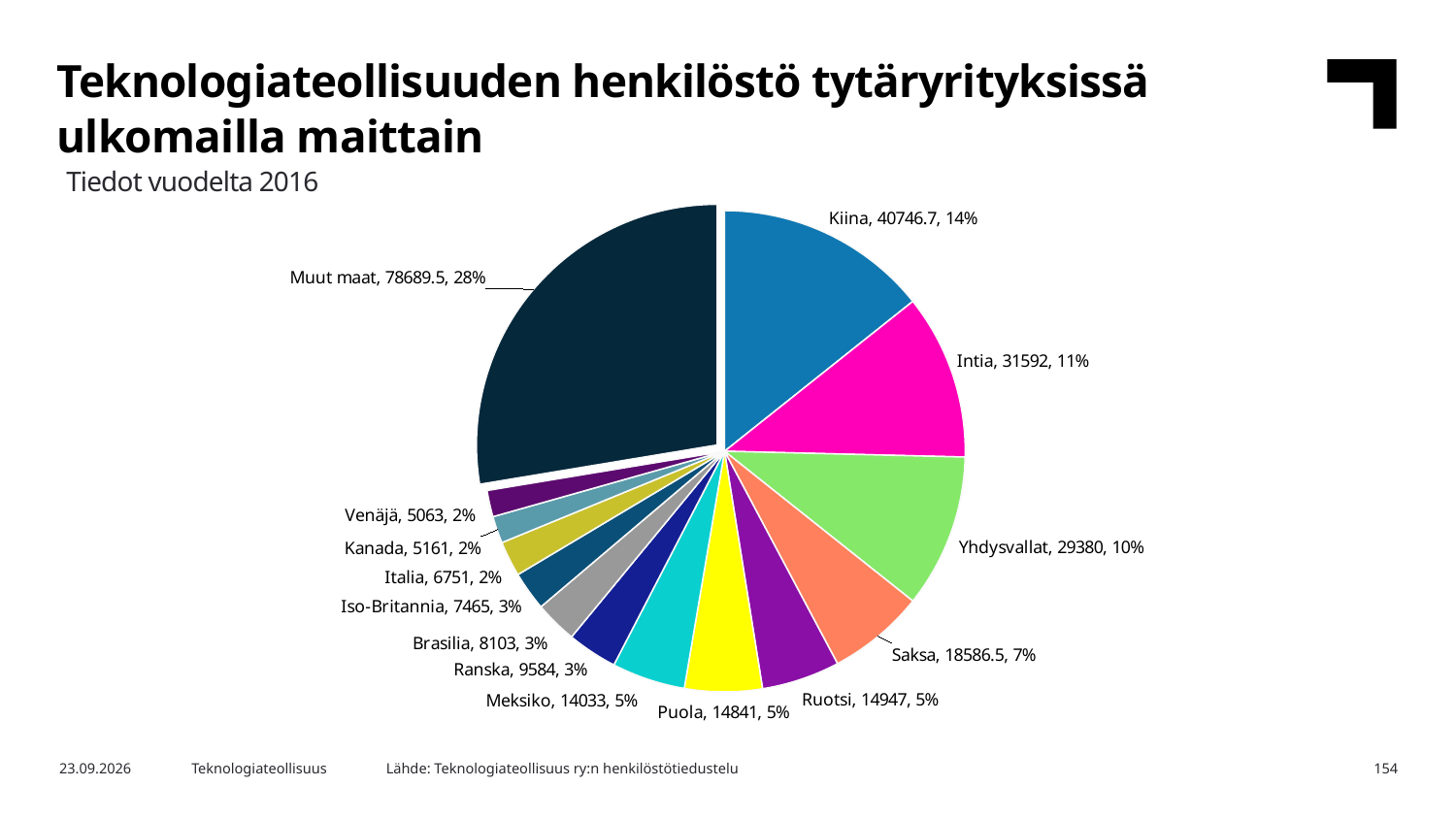
Which country slice has the smallest value? Venäjä Which slice has the largest value? Muut maat What is the difference between the values for Intia and Yhdysvallat? 2212 Which year does the data on the slide come from? 2016 What share of the pie does Muut maat represent? 28% What type of chart is shown on the slide? pie chart Which is larger, the value for Ruotsi or the value for Puola? Ruotsi What is the value for Kiina? 40746.7 What is the value for Meksiko? 14033 What is the value for Saksa? 18586.5 What share of the pie does Intia represent? 11% How many slices does the pie chart have? 14